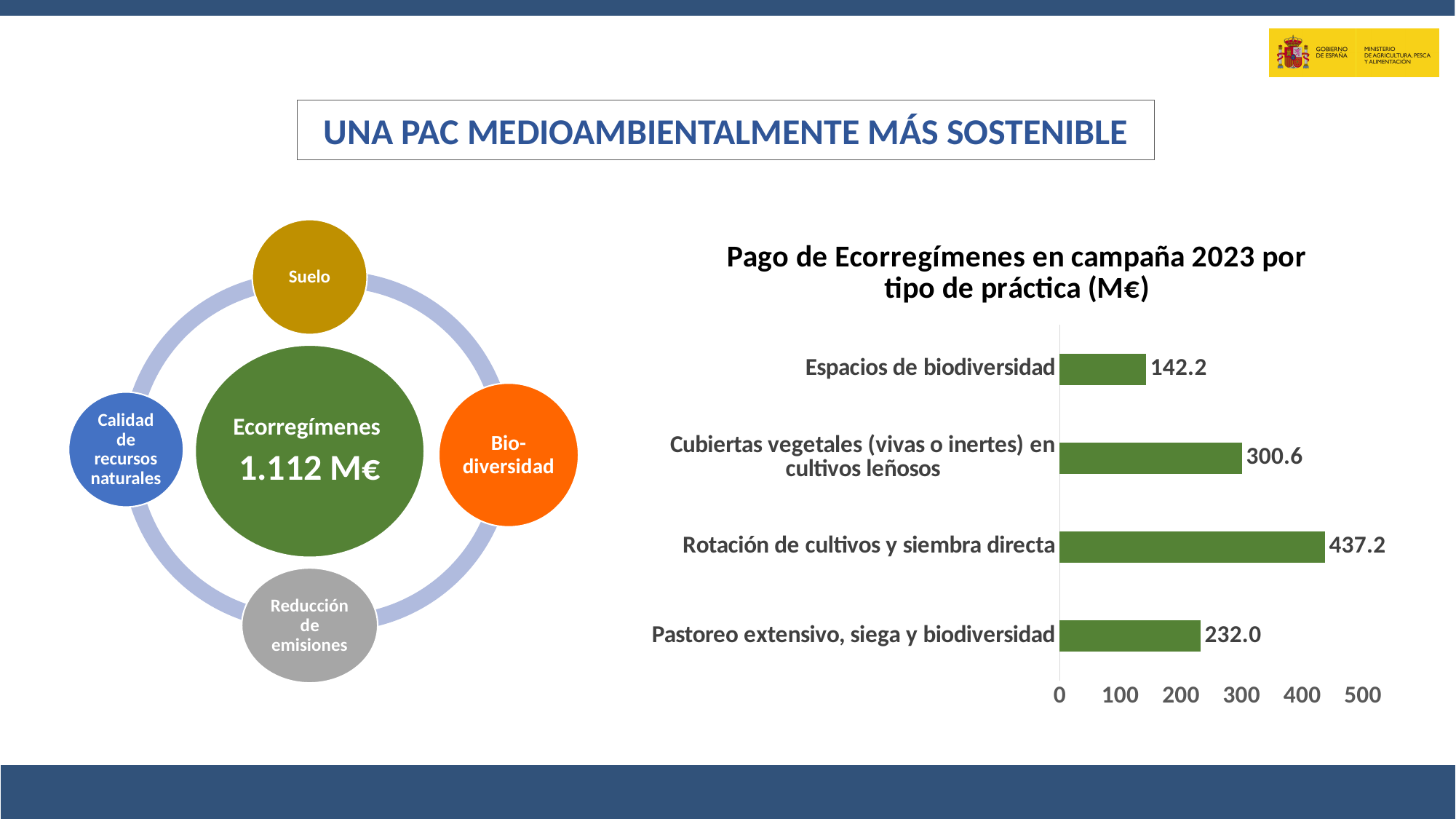
What kind of chart is shown on the slide? bar chart What is the value for Espacios de biodiversidad? 142.2 Is the value for Pastoreo extensivo, siega y biodiversidad greater or less than 300? less Which category has the highest value? Rotación de cultivos y siembra directa How many categories are shown in the chart? 4 Which category has the lowest value? Espacios de biodiversidad Which is larger: the value for Cubiertas vegetales (vivas o inertes) en cultivos leñosos or the value for Pastoreo extensivo, siega y biodiversidad? Cubiertas vegetales (vivas o inertes) en cultivos leñosos What is the difference between the values for Rotación de cultivos y siembra directa and Espacios de biodiversidad? 295.0 What is the title of the chart? Pago de Ecorregímenes en campaña 2023 por tipo de práctica (M€) What is the value for Pastoreo extensivo, siega y biodiversidad? 232.0 What is the value for Rotación de cultivos y siembra directa? 437.2 What is the value for Cubiertas vegetales (vivas o inertes) en cultivos leñosos? 300.6